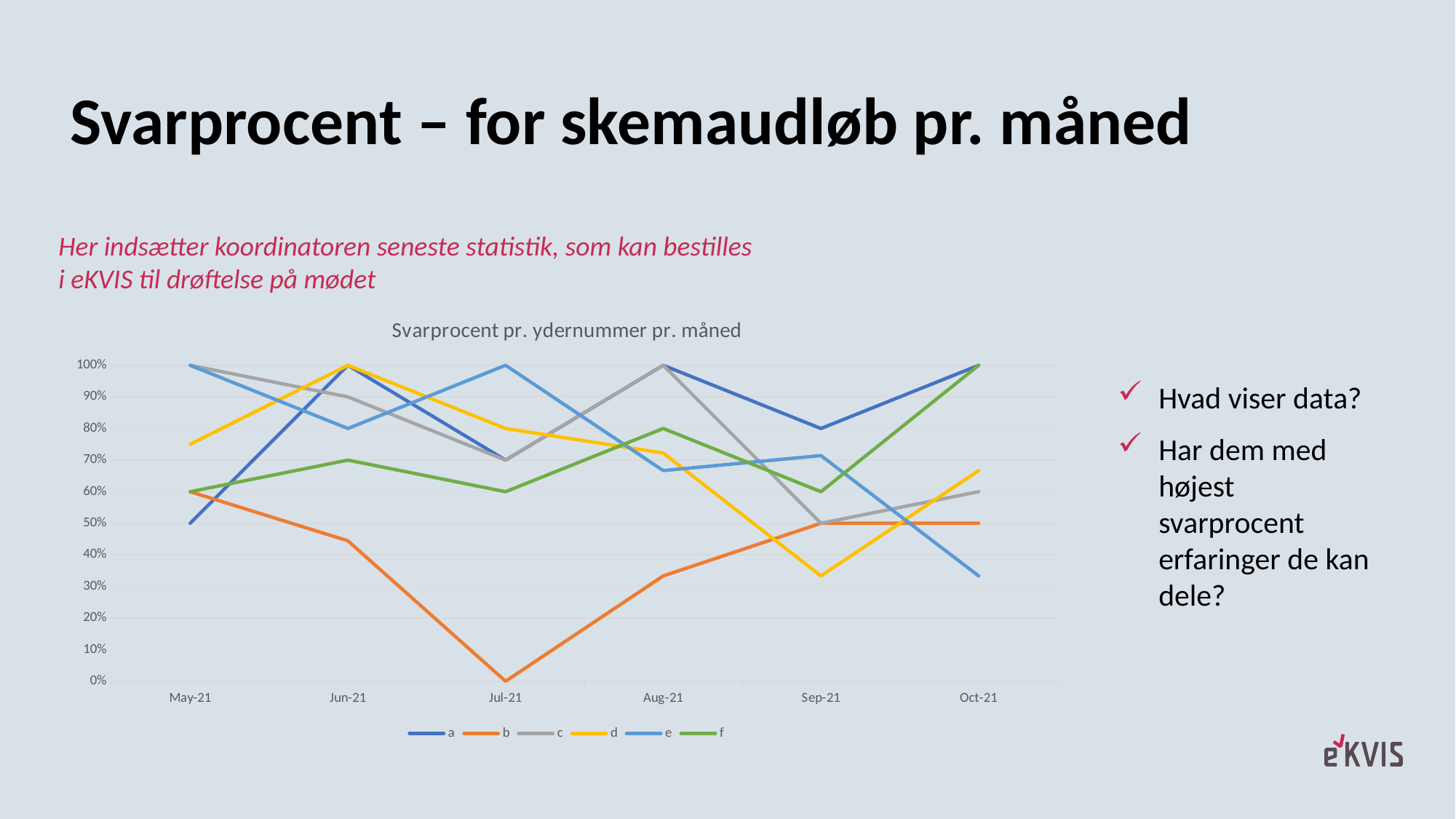
Does the value for series b rise or fall from May-21 to Jul-21? fall What kind of chart is shown on the slide? line chart Is the value for series d in Sep-21 greater or less than 40%? less How many series does the legend of the chart list? 6 What is the value for series a in Sep-21? 80% Which series has the lowest value in Jul-21? b How many months are shown on the x axis of the chart? 6 Which is larger in Oct-21, the value for series a or the value for series e? a Which series has the highest value in Sep-21? a What is the value for series b in Jul-21? 0% What is the value for series a in May-21? 50% What is the title of the chart? Svarprocent pr. ydernummer pr. måned